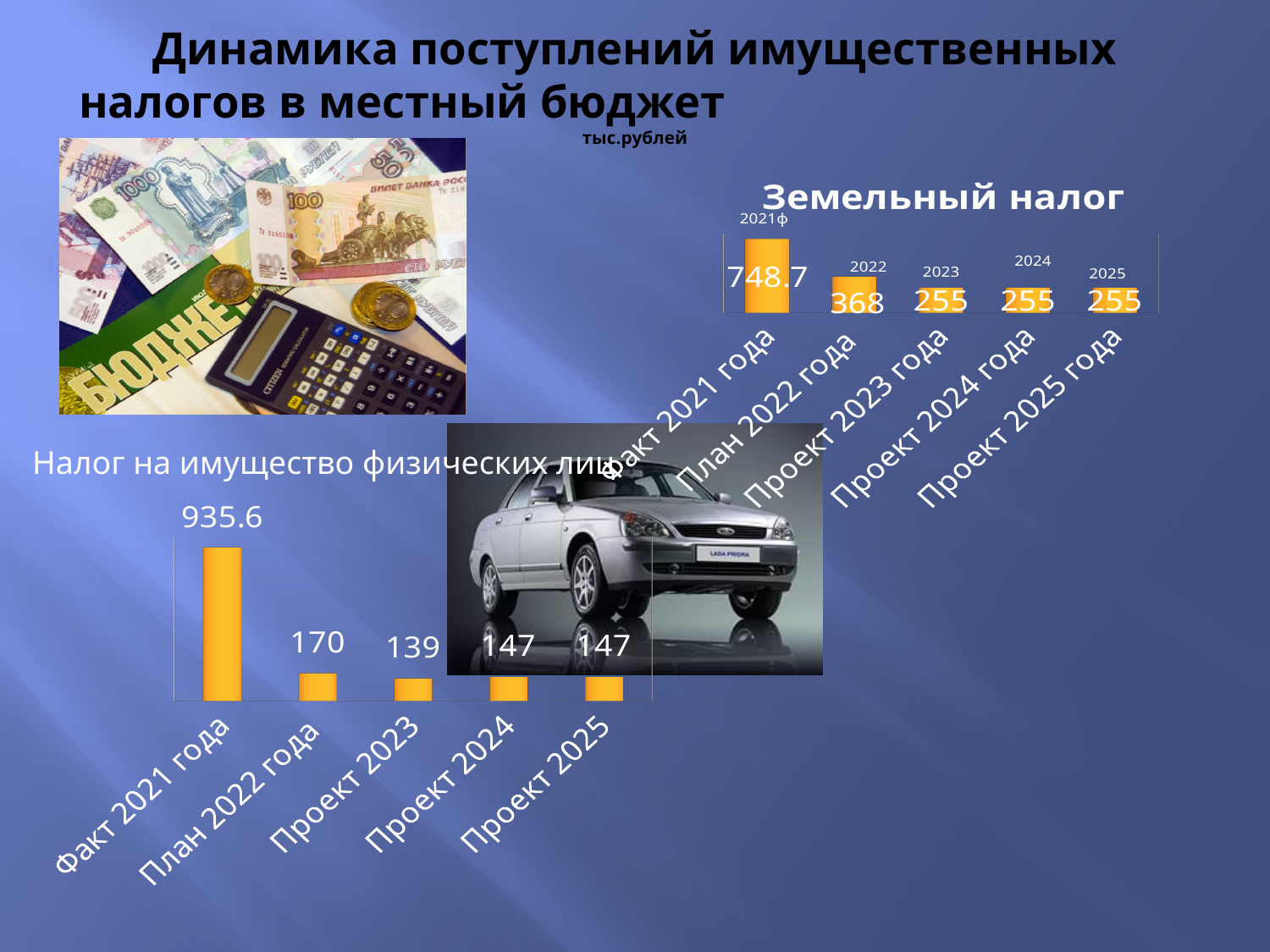
In the 'Налог на имущество физических лиц' chart, what is the difference between План 2022 года and Проект 2023? 31 In the 'Земельный налог' chart, what is the value for План 2022 года? 368 In the 'Земельный налог' chart, which category has the highest value? Факт 2021 года In the 'Земельный налог' chart, what is the difference between Факт 2021 года and План 2022 года? 380.7 In the 'Земельный налог' chart, what is the value for Факт 2021 года? 748.7 In the 'Налог на имущество физических лиц' chart, what is the value for Факт 2021 года? 935.6 What kind of chart is the 'Налог на имущество физических лиц' chart? Bar chart In the 'Налог на имущество физических лиц' chart, which is larger: План 2022 года or Проект 2024? План 2022 года In the 'Земельный налог' chart, how many categories are plotted? 5 In the 'Налог на имущество физических лиц' chart, what is the value for Проект 2023? 139 In the 'Налог на имущество физических лиц' chart, which category has the lowest value? Проект 2023 What unit is stated for the values on the slide? тыс.рублей